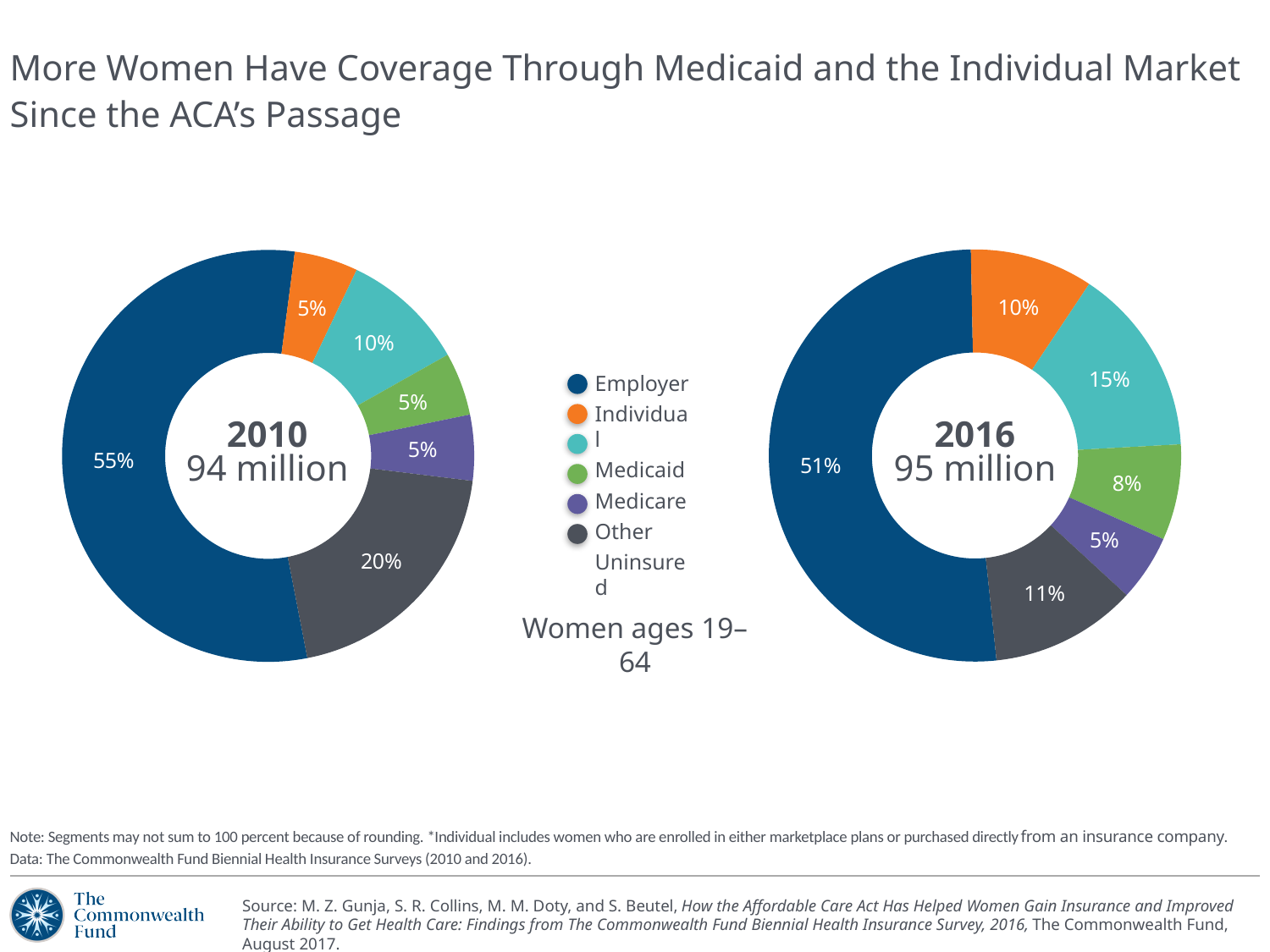
What is the difference in the uninsured share between the 2010 chart and the 2016 chart? 9 percentage points In the 2016 chart, which coverage category has the smallest share? Other What total number of women does the 2016 chart represent? 95 million Which is larger: the Medicaid share in the 2010 chart or the Medicaid share in the 2016 chart? 2016 In the 2010 chart, which coverage category has the largest share? Employer How many coverage categories does the legend list? 6 In the 2016 chart, what share of women were uninsured? 11% In the 2010 chart, what share of women had individual coverage? 5% In the 2010 chart, what share of women had employer coverage? 55% What type of chart is used on this slide? Pie chart (donut) In the 2016 chart, what share of women had Medicaid coverage? 15% Which colour represents Medicare in the charts? Purple